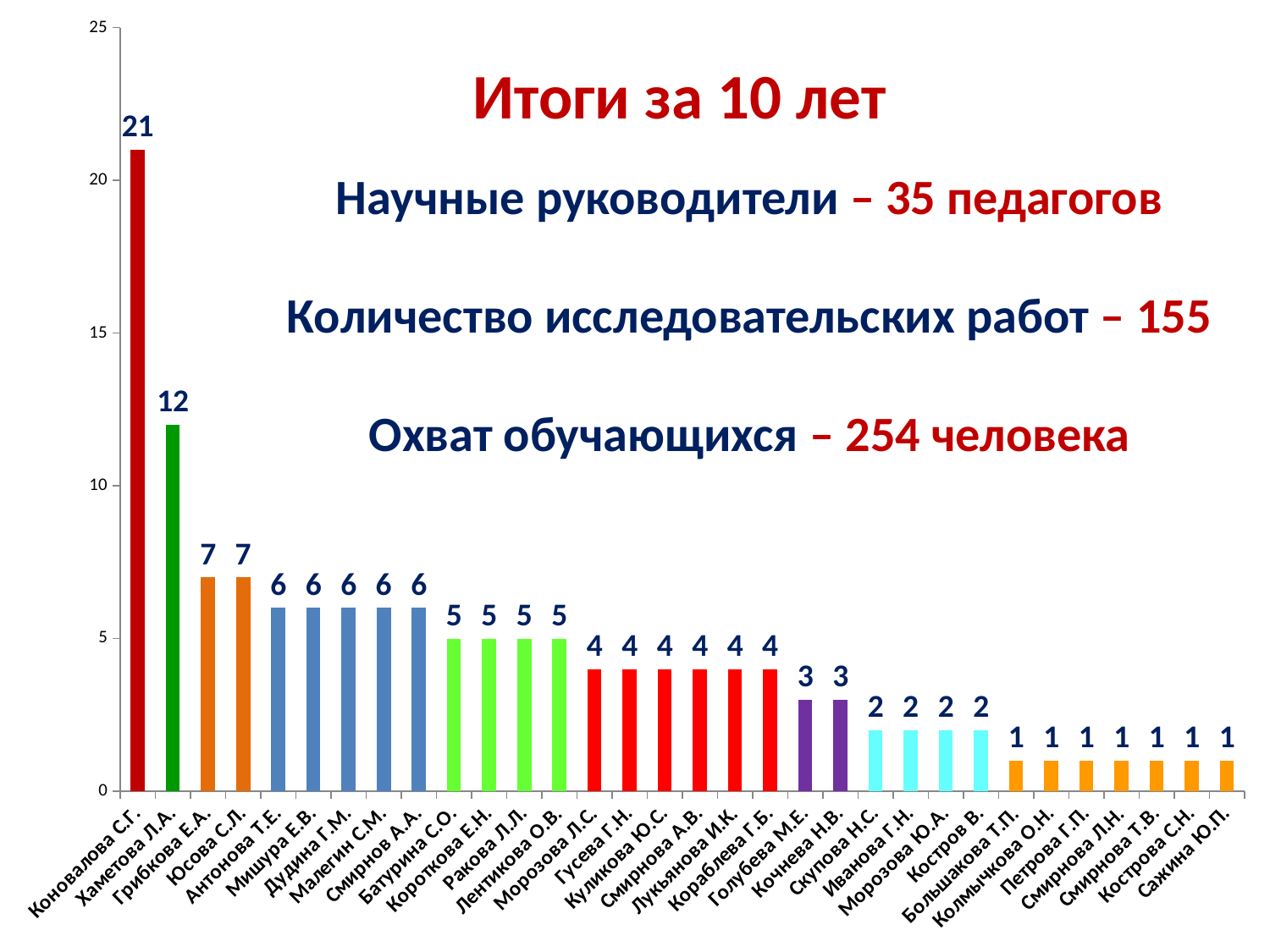
What kind of chart is shown on the slide? bar chart What is the title shown on the slide? Итоги за 10 лет What is the value for Хаметова Л.А.? 12 Which is larger, the value for Грибкова Е.А. or the value for Антонова Т.Е.? Грибкова Е.А. Do the values rise or fall from left to right along the x axis? fall What is the value for Голубева М.Е.? 3 What is the value for Сажина Ю.П.? 1 How many bars are shown in the chart? 32 Which category has the highest value? Коновалова С.Г. Is the value for Хаметова Л.А. greater or less than 10? greater What is the difference between the values for Коновалова С.Г. and Хаметова Л.А.? 9 What is the value for Коновалова С.Г.? 21